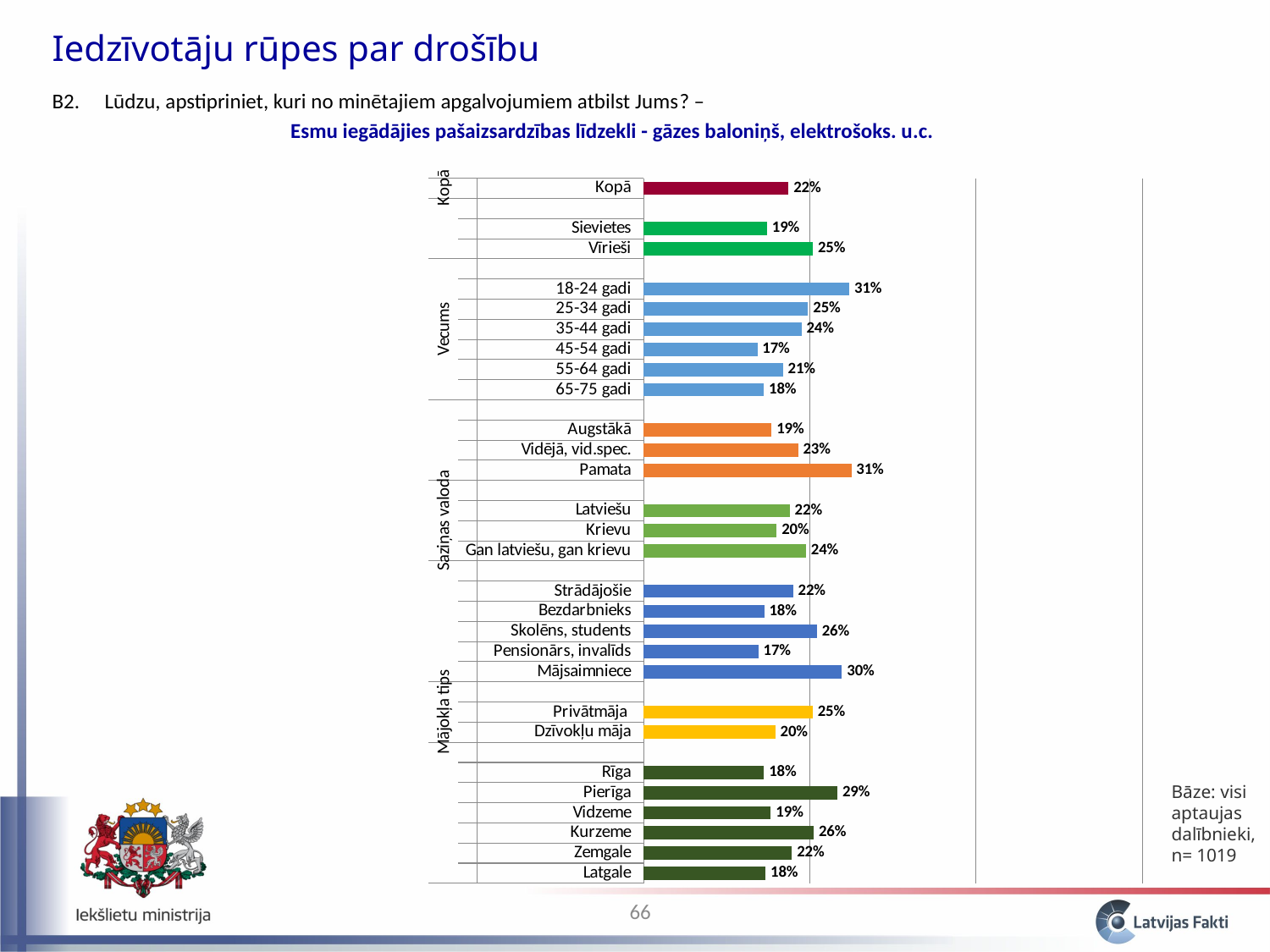
What is the difference between the values for Vīrieši and Sievietes? 6% What kind of chart is shown on the slide? Bar chart What is the value for Pierīga? 29% How many categories (bars) are plotted in the chart? 28 Among the age groups (18-24 gadi to 65-75 gadi), which has the lowest value? 45-54 gadi What is the value for Kopā? 22% What is the difference between the values for Pamata and Augstākā? 12% Which is larger, the value for Privātmāja or Dzīvokļu māja? Privātmāja Among the age groups (18-24 gadi to 65-75 gadi), which has the highest value? 18-24 gadi What is the value for Mājsaimniece? 30% Among the regions (Rīga, Pierīga, Vidzeme, Kurzeme, Zemgale, Latgale), which has the highest value? Pierīga What is the value for Gan latviešu, gan krievu? 24%